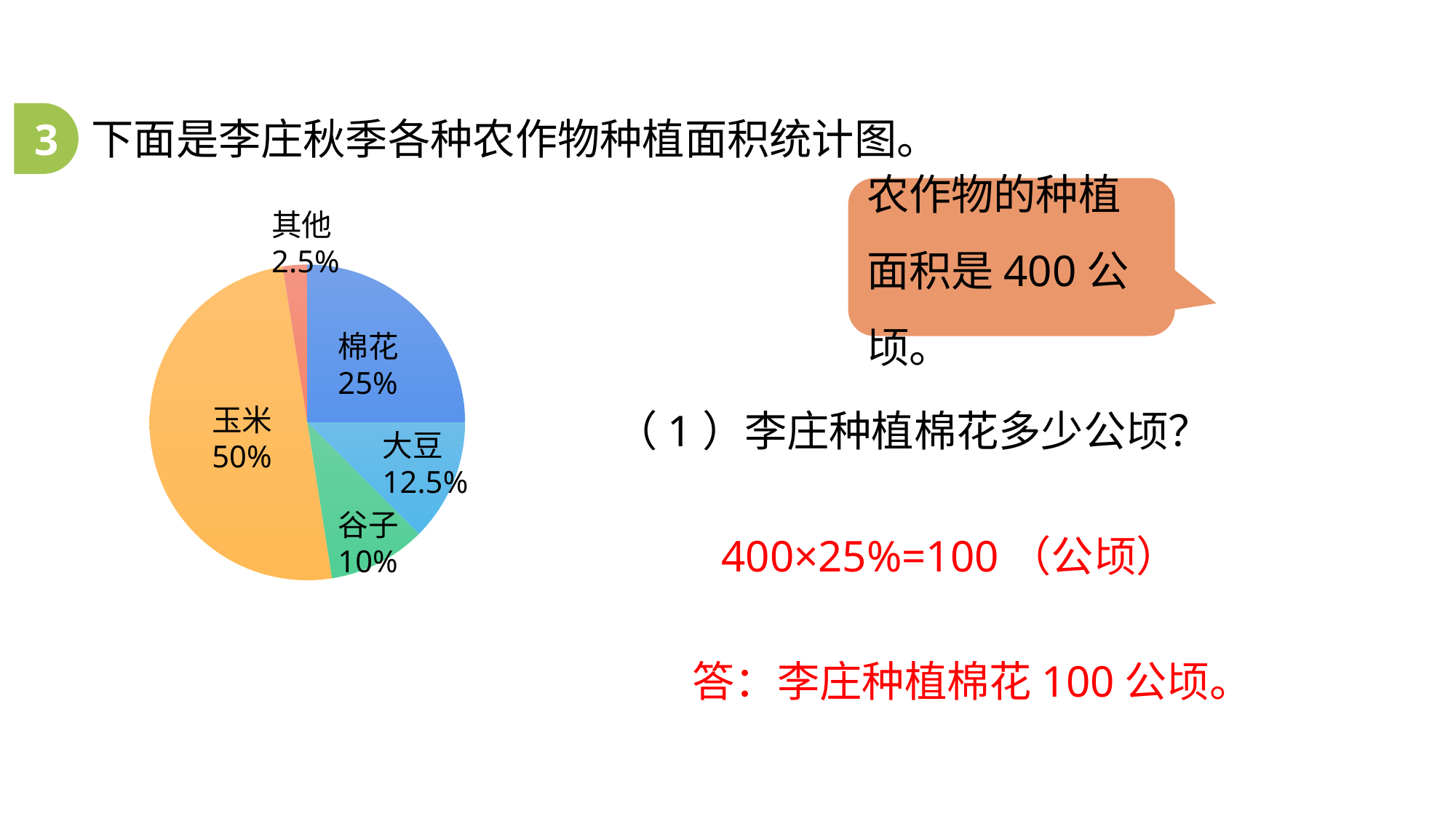
What is the difference in percentage points between the shares of 玉米 and 棉花? 25% What kind of chart is shown on the slide? pie chart What share of the pie does 玉米 (corn) take? 50% What share of the pie does 谷子 (millet) take? 10% What share of the pie does 大豆 (soybean) take? 12.5% Which crop has the smallest share of the planting area? 其他 Which crop has the largest share of the planting area? 玉米 What colour is the 玉米 slice? orange Which has a larger share, 棉花 or 大豆? 棉花 How many slices does the pie chart have? 5